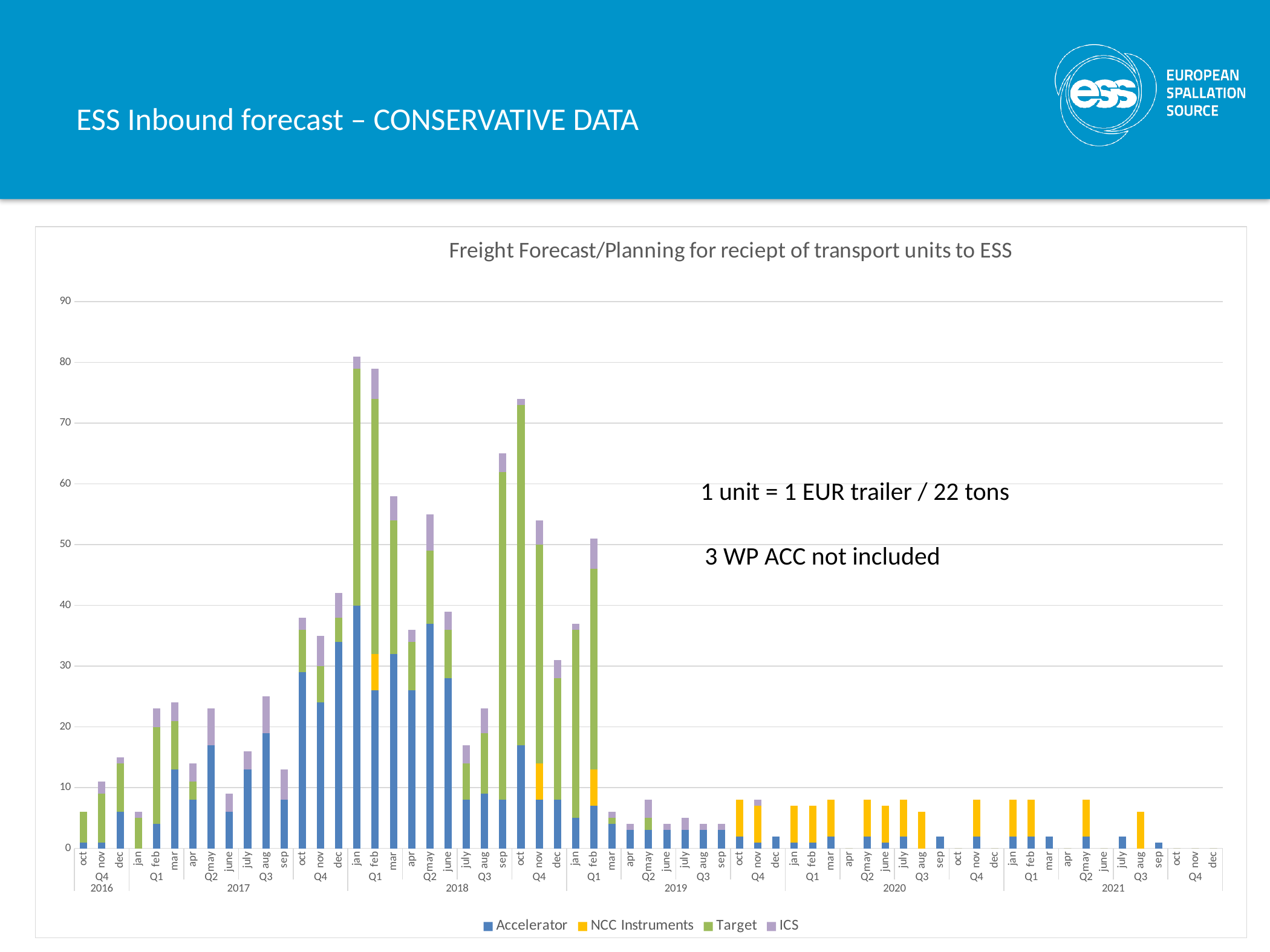
Is the total value for oct 2017 greater or less than 40? less Do the bar totals generally rise or fall from 2018 to 2020? fall Is the total value for jan 2018 greater or less than 70? greater How many series does the legend list? 4 Which has the larger total bar, jan 2018 or jan 2019? jan 2018 Is the total value for sep 2018 greater or less than 60? greater Which series is shown in yellow in the legend? NCC Instruments What is the title of the chart? Freight Forecast/Planning for reciept of transport units to ESS Which has the larger total bar, oct 2018 or nov 2018? oct 2018 What kind of chart is shown on the slide? stacked bar chart